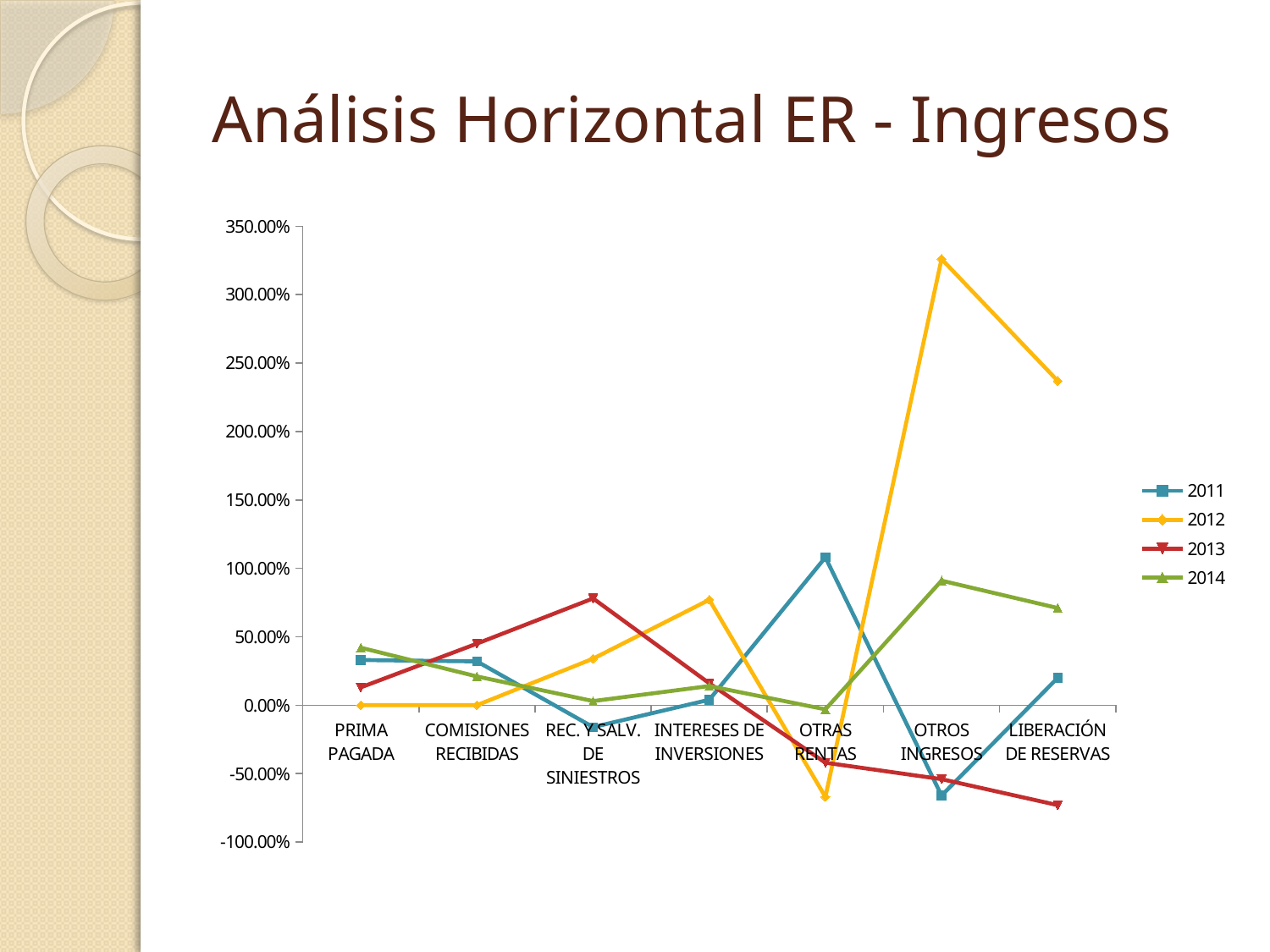
How many categories are shown on the x axis? 7 Which category has the lowest value for the 2013 series? LIBERACIÓN DE RESERVAS What kind of chart is shown on the slide? Line chart Is the 2012 value for OTRAS RENTAS greater or less than -50.00%? less Which category has the highest value for the 2012 series? OTROS INGRESOS Does the 2013 series rise or fall from OTRAS RENTAS to LIBERACIÓN DE RESERVAS? Fall Which series has the highest value at OTROS INGRESOS? 2012 Is the 2012 value for OTROS INGRESOS greater or less than 300.00%? greater How many series does the legend list? 4 At PRIMA PAGADA, which series has the larger value, 2013 or 2014? 2014 What is the title of the slide? Análisis Horizontal ER - Ingresos Is the 2013 value for LIBERACIÓN DE RESERVAS greater or less than -50.00%? less